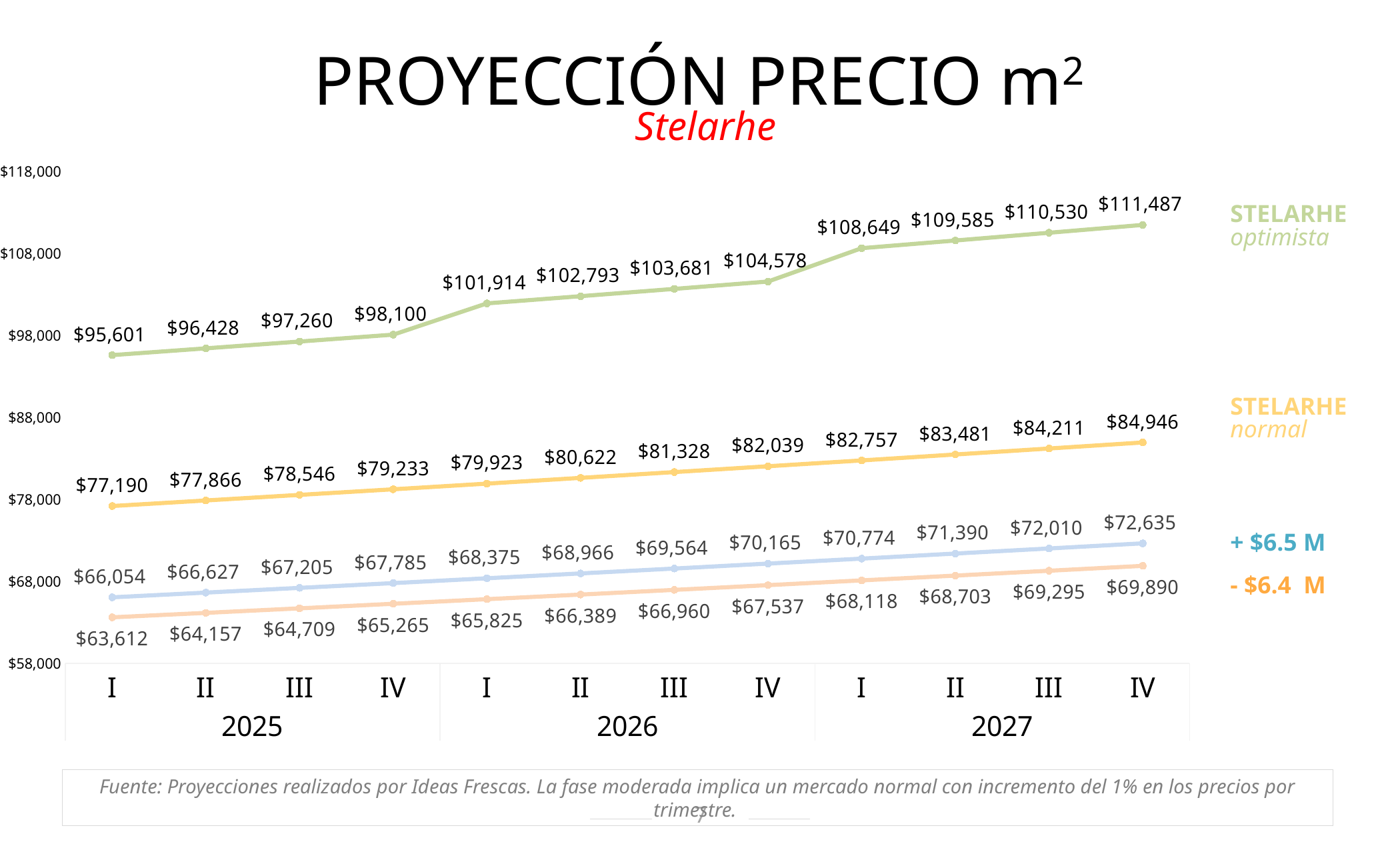
What kind of chart is shown on the slide? Line chart In which quarter is the STELARHE optimista series at its lowest value? I 2025 Which series has the larger value in quarter IV of 2026, STELARHE optimista or STELARHE normal? STELARHE optimista How many series are shown in the chart? 4 What is the value of the + $6.5 M series in quarter II of 2026? $68,966 What is the difference between the STELARHE optimista value in quarter IV of 2027 and in quarter I of 2025? $15,886 In which quarter does the STELARHE normal series reach its highest value? IV 2027 Do the values of the STELARHE normal series rise or fall from quarter I of 2025 to quarter IV of 2027? Rise What is the value of the STELARHE optimista series in quarter IV of 2027? $111,487 What is the value of the STELARHE normal series in quarter I of 2025? $77,190 What is the value of the - $6.4 M series in quarter III of 2027? $69,295 How many quarters are plotted along the x axis? 12